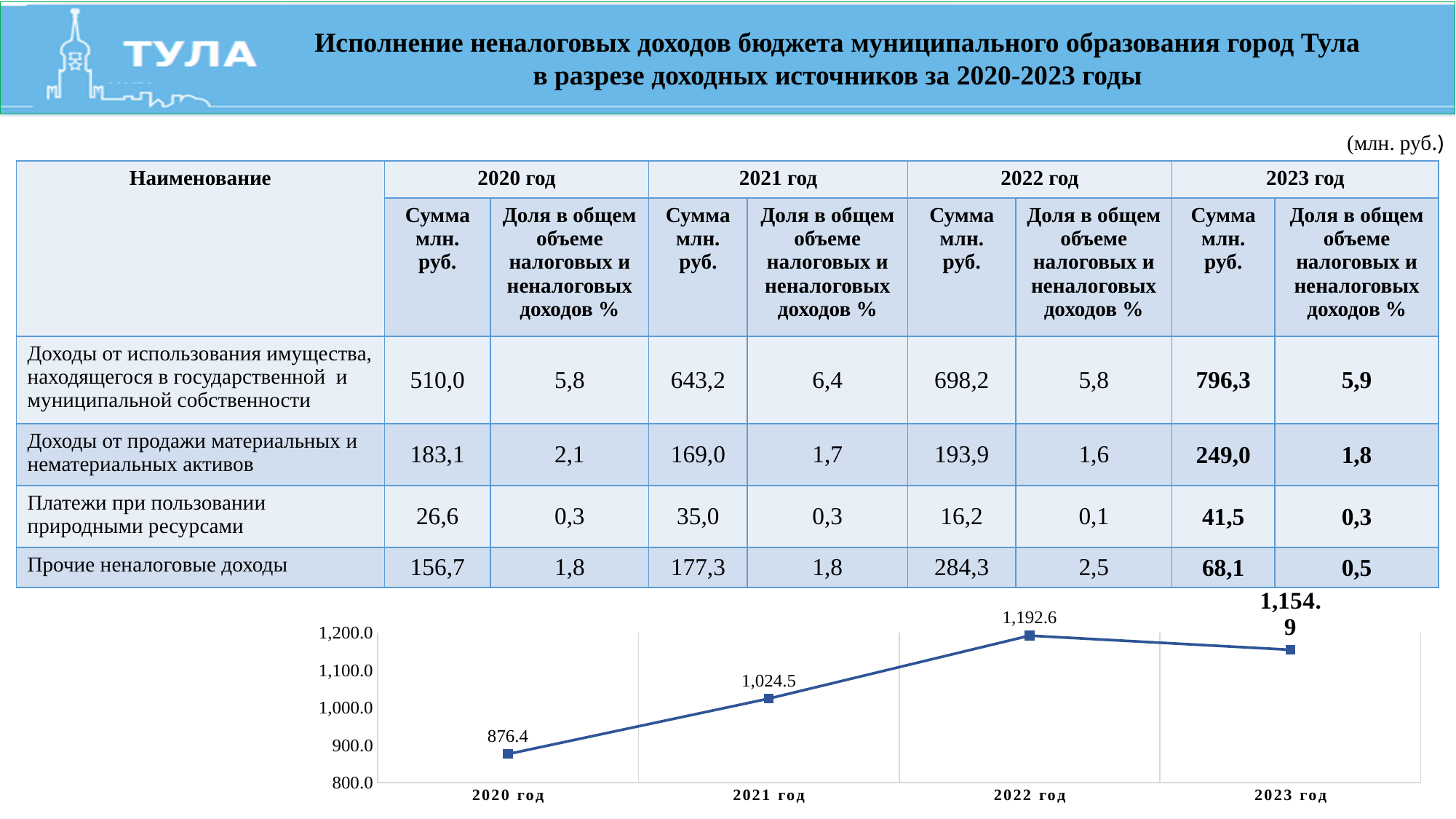
What is the value plotted for 2020 год on the line chart? 876.4 Which year has the highest value on the line chart? 2022 год What is the value plotted for 2022 год on the line chart? 1,192.6 Which is larger on the line chart, the value for 2021 год or the value for 2023 год? 2023 год By how much does the value for 2022 год exceed the value for 2023 год on the line chart? 37.7 What is the value plotted for 2023 год on the line chart? 1,154.9 How many data points are plotted on the line chart? 4 What kind of chart is shown at the bottom of the slide? line chart Is the value for 2020 год on the line chart greater or less than 900.0? less Which year has the lowest value on the line chart? 2020 год What is the value plotted for 2021 год on the line chart? 1,024.5 What is the difference between the values for 2021 год and 2020 год on the line chart? 148.1